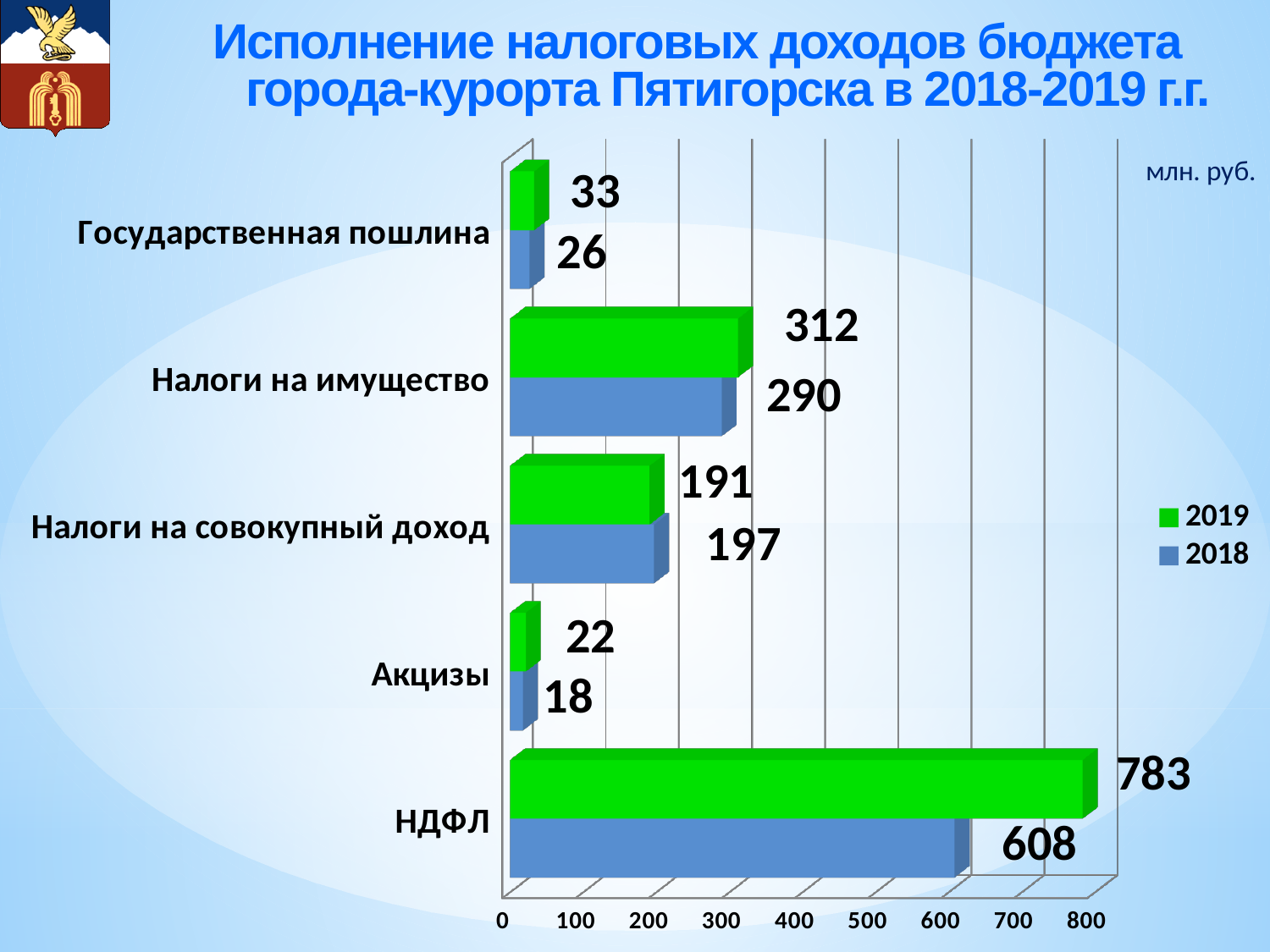
How many categories are shown on the chart? 5 Which category has the lowest 2018 value? Акцизы What is the 2018 value for Налоги на имущество? 290 What kind of chart is shown on the slide? bar chart How many series does the legend list? 2 What is the difference between the 2019 and 2018 values for НДФЛ? 175 Is the 2019 value for Налоги на имущество greater or less than 300? greater Which category has the highest 2019 value? НДФЛ Which is larger for Налоги на совокупный доход, the 2019 value or the 2018 value? 2018 What is the 2018 value for Акцизы? 18 What is the 2019 value for НДФЛ? 783 What unit is indicated in the top right corner of the chart? млн. руб.